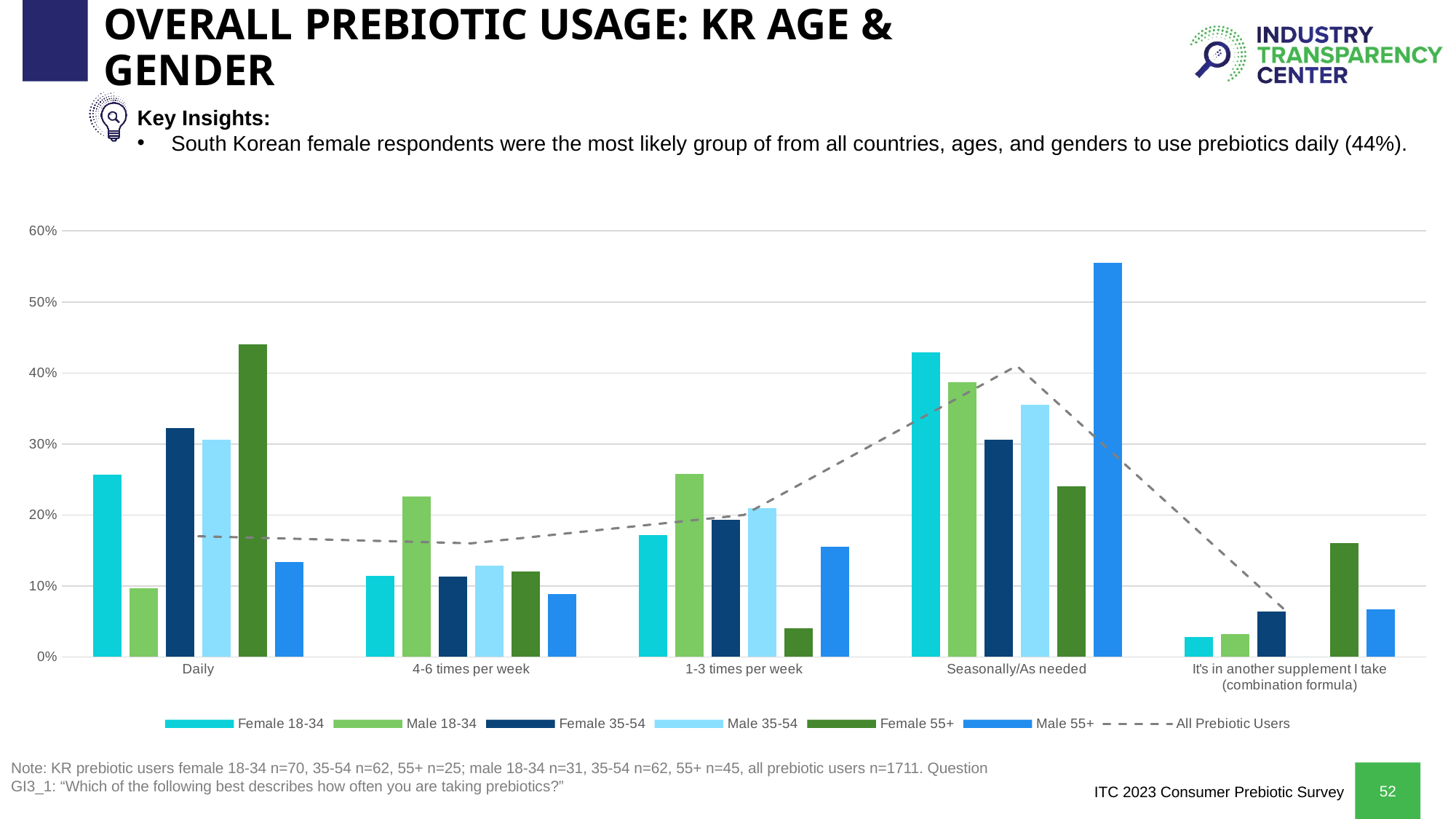
Which series has the highest bar in the Daily category? Female 55+ How many series does the legend list? 7 In the Daily category, which is larger: Female 18-34 or Female 35-54? Female 35-54 Is the value for Female 55+ in 1-3 times per week greater or less than 10%? less Which series is drawn as a dashed line rather than bars? All Prebiotic Users What kind of chart is shown on the slide? Bar chart with a dashed line series Which series has the lowest bar in the 1-3 times per week category? Female 55+ In which category is the Male 55+ bar highest? Seasonally/As needed Is the value for Female 18-34 in Seasonally/As needed greater or less than 40%? greater Is the value for Male 55+ in Seasonally/As needed greater or less than 50%? greater How many usage-frequency categories are shown on the x axis? 5 Which series has the highest bar in the 4-6 times per week category? Male 18-34